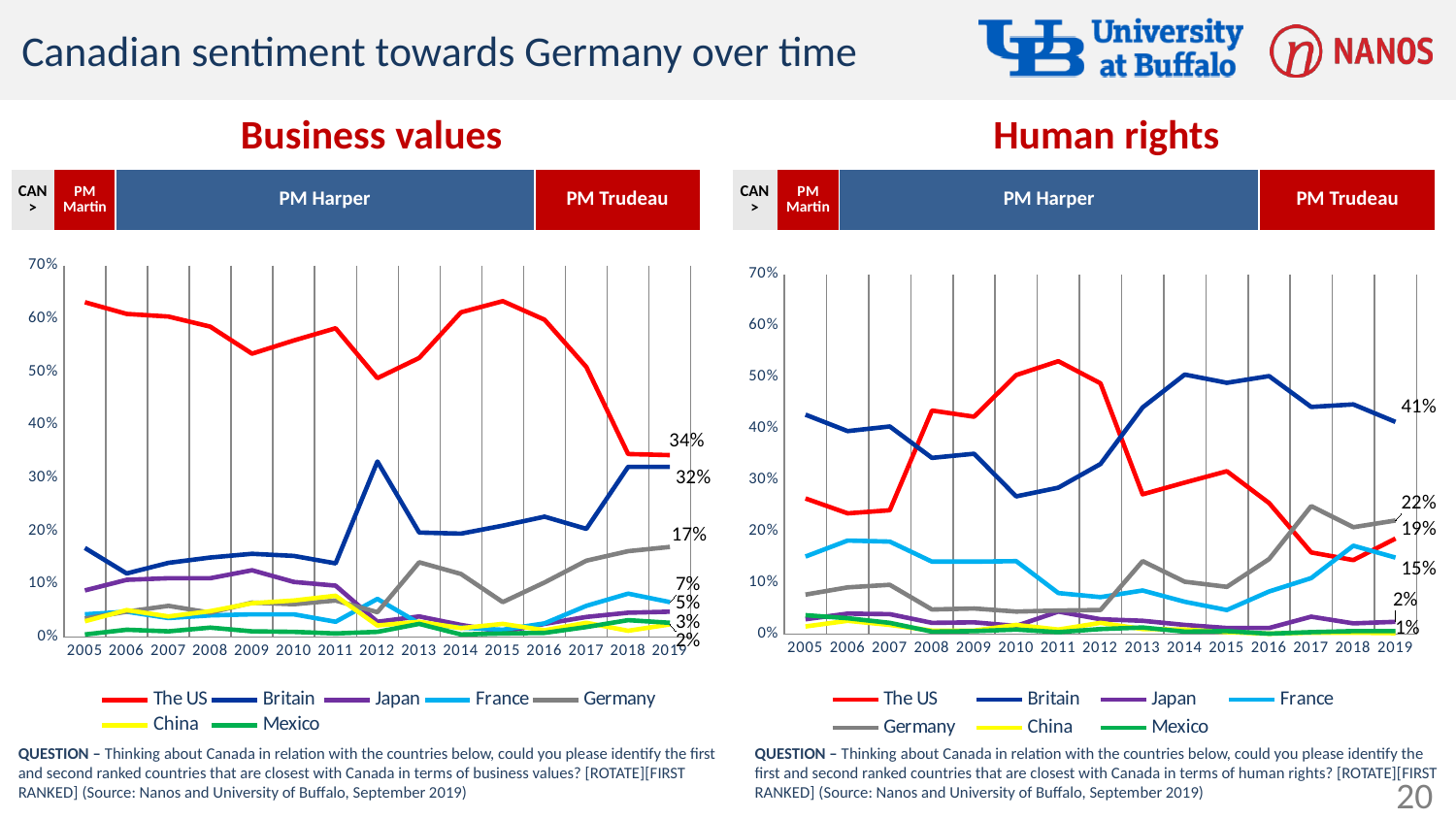
In the Business values chart, what is the value for Britain in 2019? 32% How many years are shown on the x axis of the Business values chart? 15 In the Human rights chart, what is the value for Germany in 2019? 22% What kind of chart is the Business values chart? Line chart In the Human rights chart, does the value for The US rise or fall from 2011 to 2019? fall In the Business values chart, what is the difference between The US and Britain in 2019? 2 percentage points In the Business values chart, is the value for The US in 2005 greater or less than 60%? greater How many series does the legend of the Human rights chart list? 7 In the Human rights chart, which series has the highest value in 2019? Britain In the Business values chart, what is the value for The US in 2019? 34% In the Human rights chart, what is the value for Britain in 2019? 41% In the Business values chart, what is the value for Germany in 2019? 17%